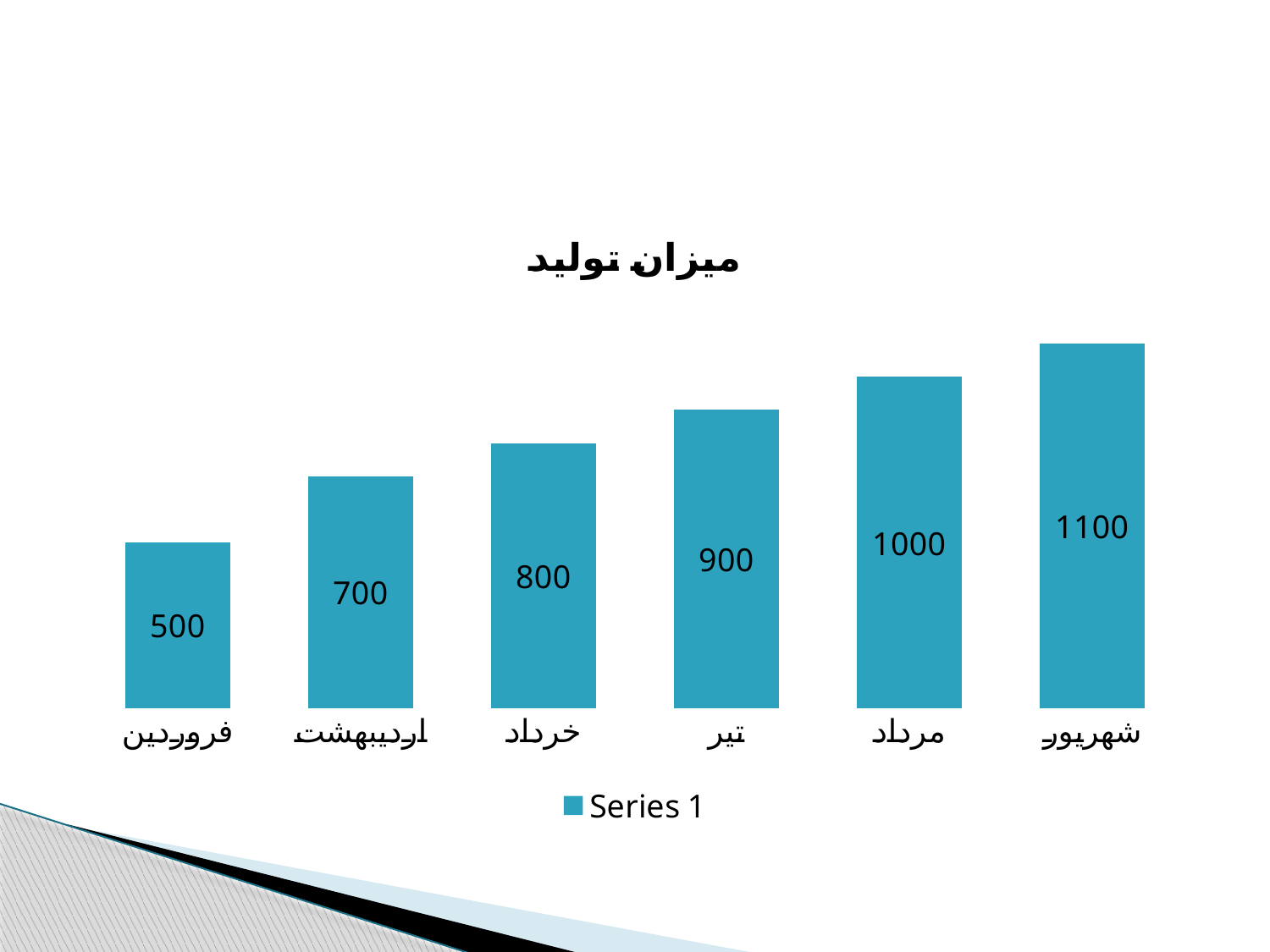
How many categories are shown on the x axis? 6 What type of chart is shown on the slide? Bar chart Which is larger, the value for تیر or the value for خرداد? تیر What is the value for فروردین? 500 What is the value for شهریور? 1100 What is the difference between the values for مرداد and اردیبهشت? 300 Which category has the highest value? شهریور How many series does the legend list? 1 Which category has the lowest value? فروردین What is the value for خرداد? 800 What is the title of the chart? میزان تولید Do the values rise or fall from فروردین to شهریور? Rise